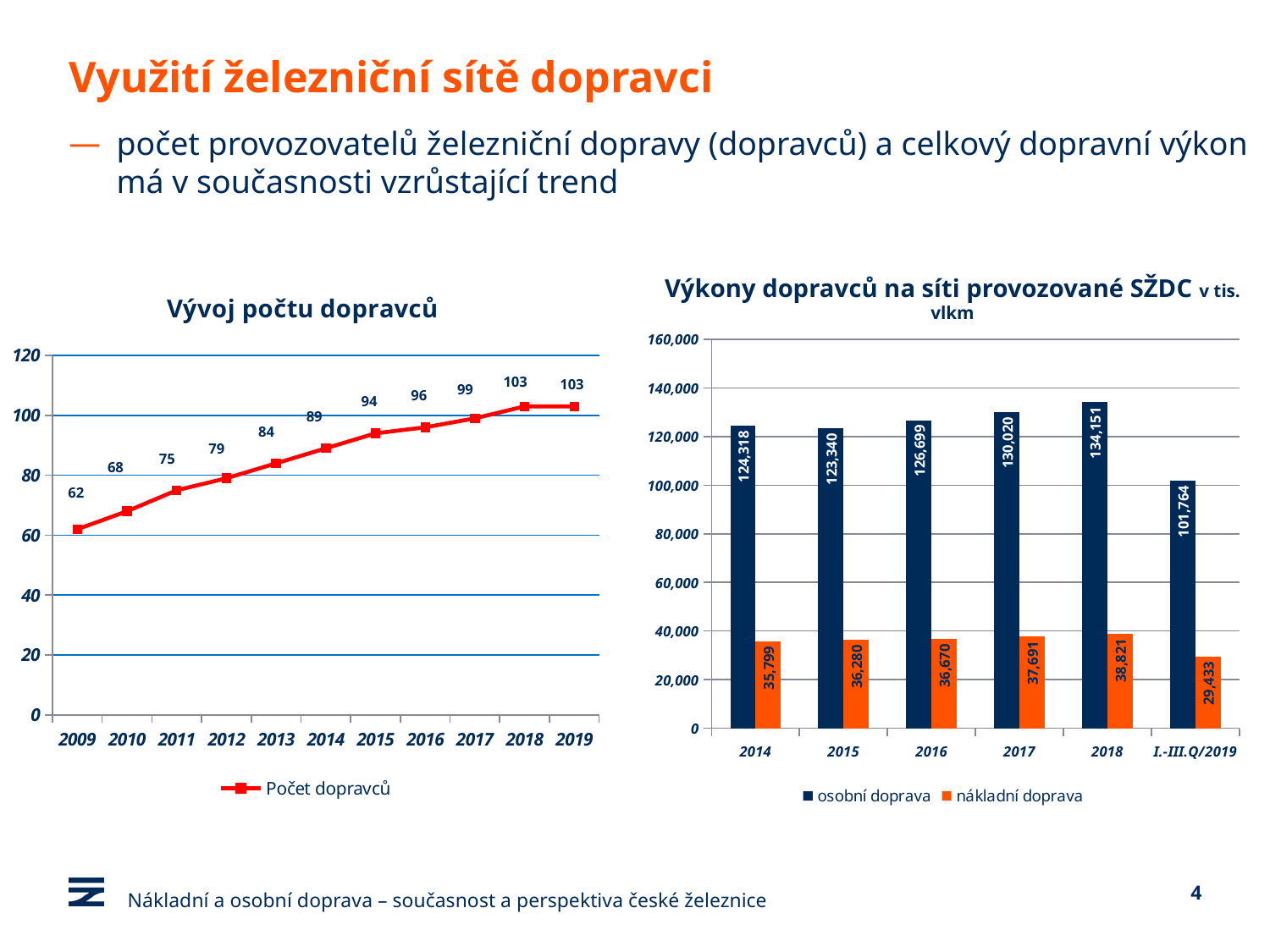
In the chart 'Výkony dopravců na síti provozované SŽDC', what is the value of osobní doprava for 2018? 134,151 In the chart 'Výkony dopravců na síti provozované SŽDC', what is the value of nákladní doprava for 2016? 36,670 In the chart 'Vývoj počtu dopravců', what is the value for 2009? 62 In the chart 'Vývoj počtu dopravců', what is the difference between the values for 2019 and 2009? 41 In the chart 'Vývoj počtu dopravců', do the values generally rise or fall from 2009 to 2019? rise In the chart 'Výkony dopravců na síti provozované SŽDC', which year has the highest value for osobní doprava? 2018 In the chart 'Vývoj počtu dopravců', what is the value for 2015? 94 How many series does the legend of the chart 'Výkony dopravců na síti provozované SŽDC' list? 2 In the chart 'Vývoj počtu dopravců', how many years are plotted on the x axis? 11 In the chart 'Výkony dopravců na síti provozované SŽDC', which category has the lowest value for nákladní doprava? I.-III.Q/2019 What kind of chart is 'Vývoj počtu dopravců'? line chart In the chart 'Výkony dopravců na síti provozované SŽDC', what is the difference between osobní doprava and nákladní doprava in 2014? 88,519